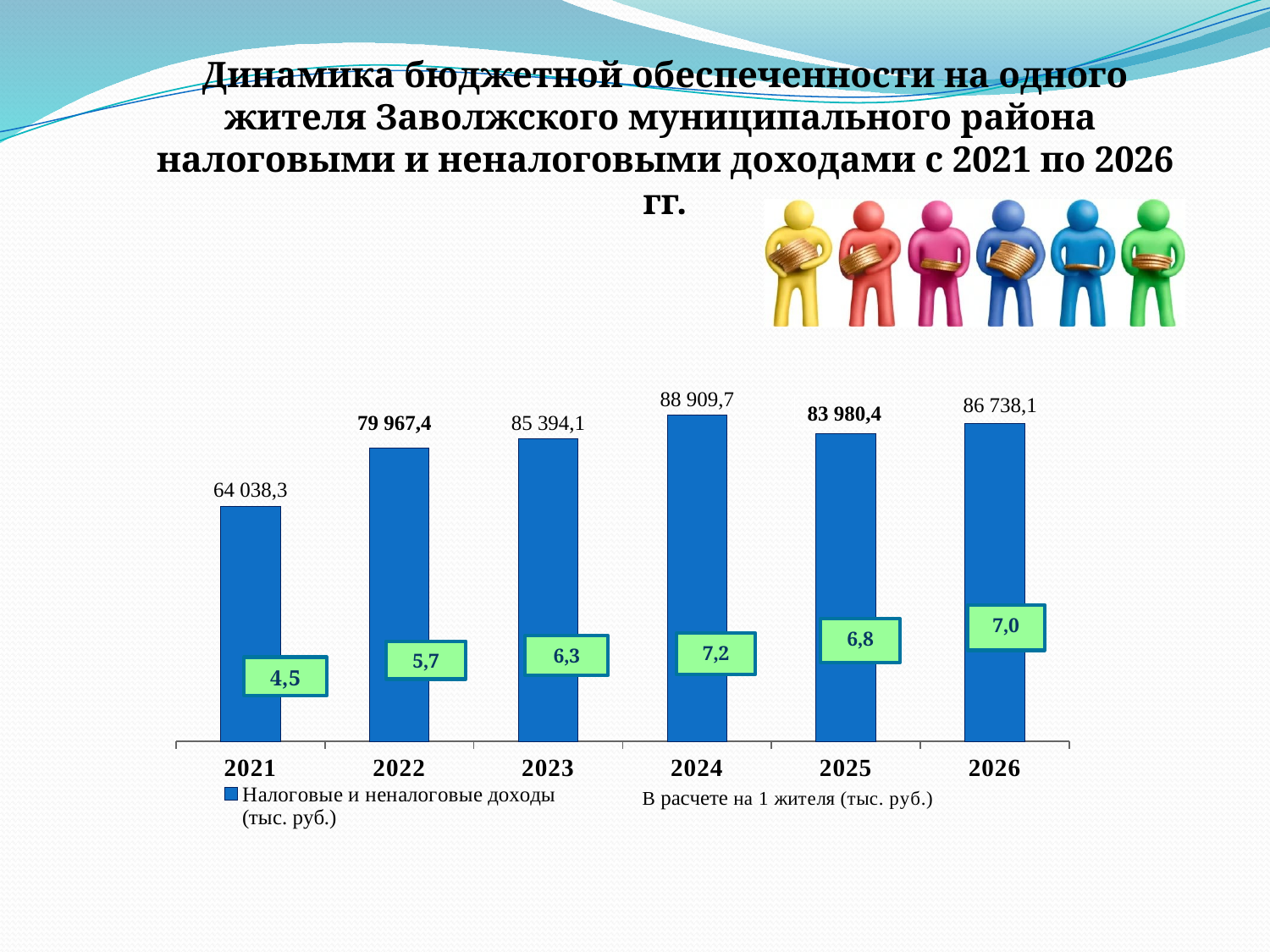
What is the per-resident value (В расчете на 1 жителя) shown for 2026? 7,0 Which year has the highest tax and non-tax revenues? 2024 Which year has larger tax and non-tax revenues, 2025 or 2026? 2026 What is the value of tax and non-tax revenues (тыс. руб.) for 2024? 88 909,7 What is the per-resident value (В расчете на 1 жителя) shown for 2023? 6,3 What is the difference between the per-resident values for 2024 and 2021? 2,7 Do the tax and non-tax revenues rise or fall from 2021 to 2024? Rise What is the difference between the tax and non-tax revenues for 2024 and 2021? 24 871,4 What kind of chart is shown on the slide? Bar chart What is the value of tax and non-tax revenues (тыс. руб.) for 2021? 64 038,3 Which year has the lowest tax and non-tax revenues? 2021 How many years are shown on the x axis of the chart? 6